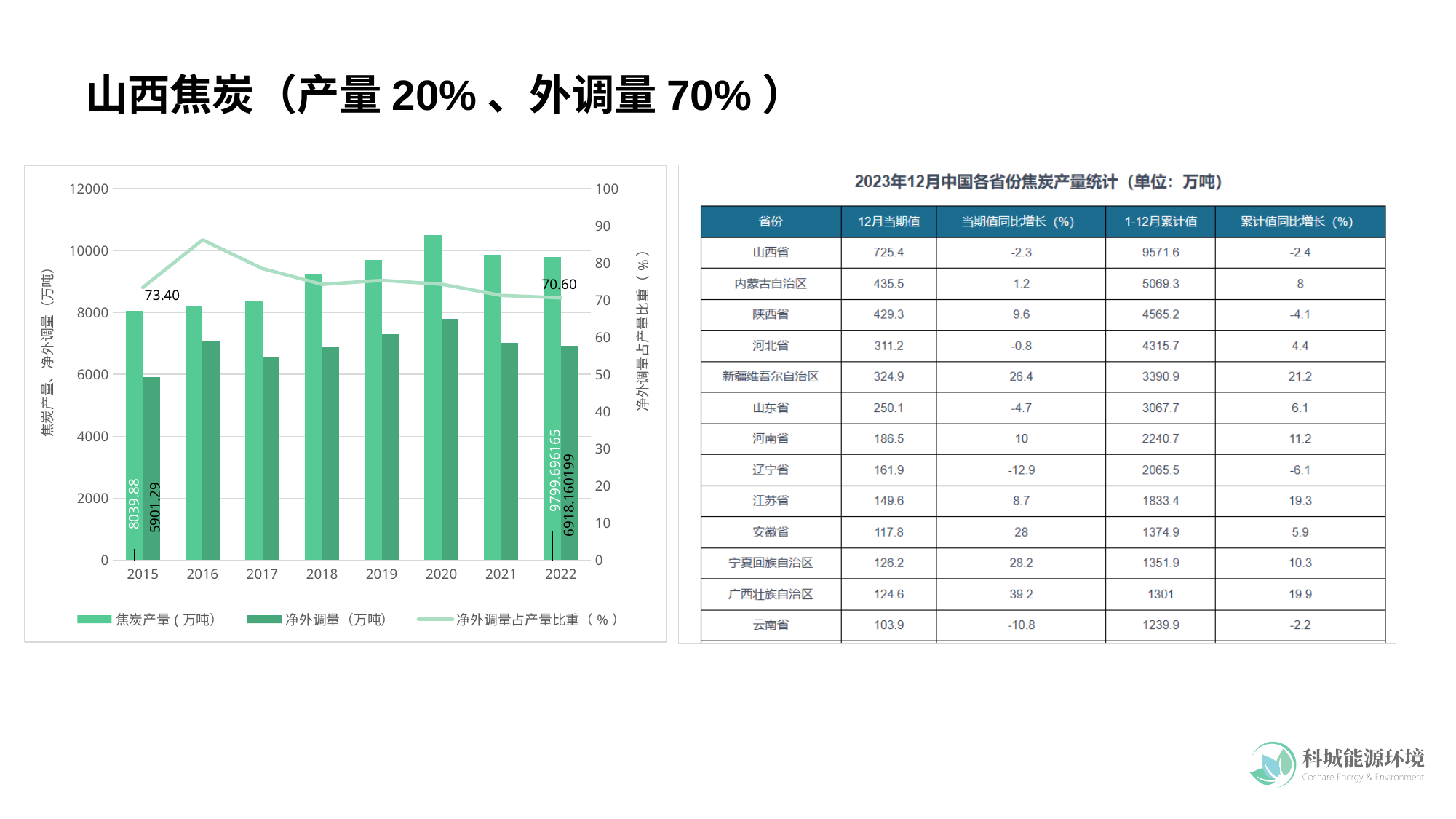
How many series does the chart legend list? 3 By how much did the 净外调量占产量比重 (%) fall from 2015 to 2022? 2.80 Which year has the lowest 净外调量 (万吨) bar? 2015 Is the 净外调量 (万吨) value for 2017 greater or less than 7000? less What is the 焦炭产量 (万吨) value for 2015? 8039.88 How many years are shown on the x axis of the chart? 8 What is the difference between 焦炭产量 and 净外调量 in 2015? 2138.59 In which year does the 净外调量占产量比重 (%) line reach its highest point? 2016 Which year has the highest 焦炭产量 (万吨) bar? 2020 Is the 焦炭产量 (万吨) value for 2020 greater or less than 10000? greater What is the 净外调量 (万吨) value for 2022? 6918.160199 What is the 净外调量占产量比重 (%) value for 2022? 70.60